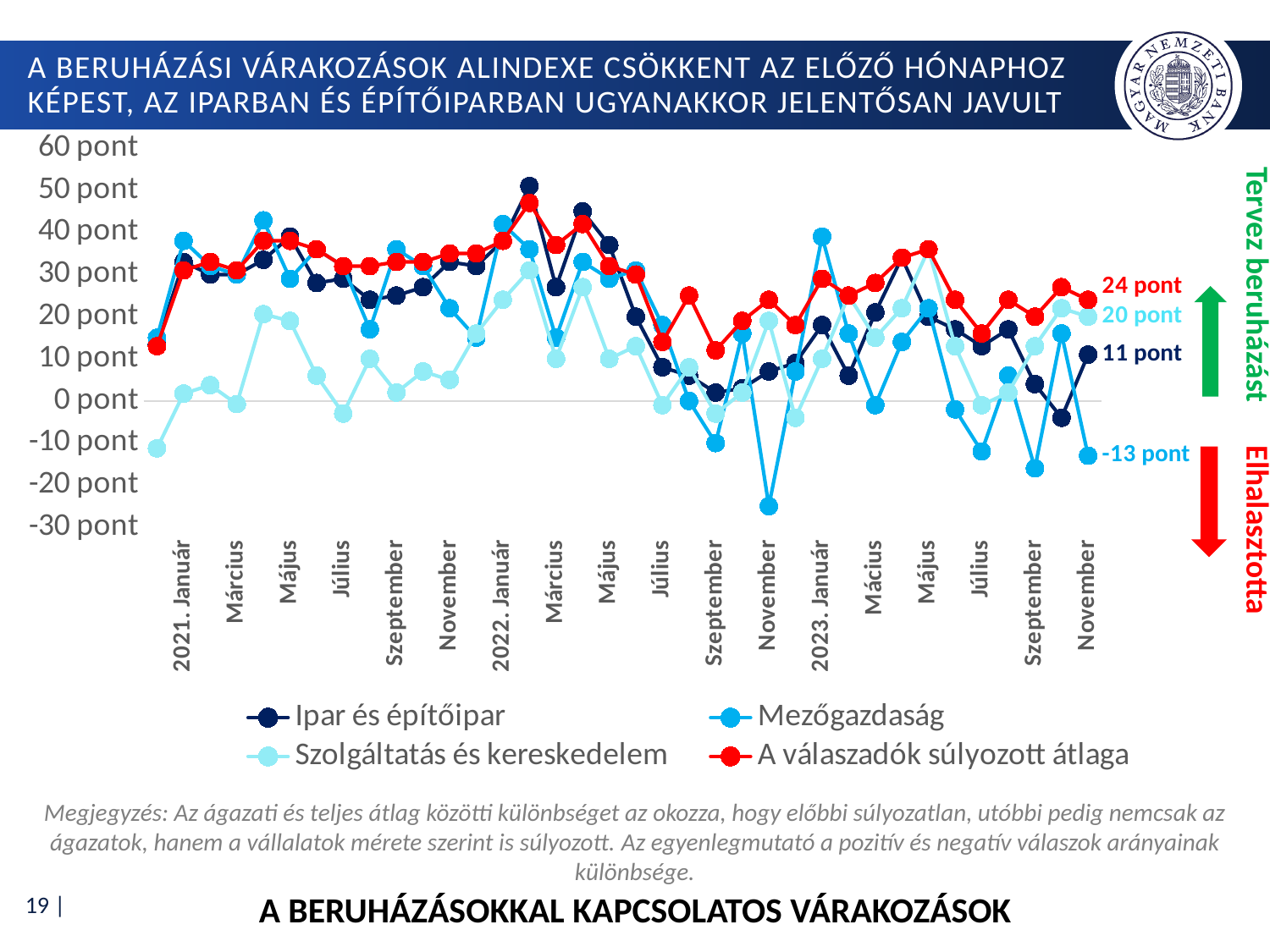
Which series has the highest value at the last point (November 2023)? A válaszadók súlyozott átlaga What is the value of 'Szolgáltatás és kereskedelem' at the last point (November 2023)? 20 pont Between 2022 February and 2022 July, does the 'A válaszadók súlyozott átlaga' line rise or fall? fall Which series has the lowest value at the last point (November 2023)? Mezőgazdaság Is the value for 'Mezőgazdaság' in November 2022 greater or less than -20 pont? less What is the value of 'A válaszadók súlyozott átlaga' at the last point (November 2023)? 24 pont What is the value of 'Ipar és építőipar' at the last point (November 2023)? 11 pont How many series does the legend list? 4 What is the title of the chart shown at the bottom of the slide? A beruházásokkal kapcsolatos várakozások What is the value of 'Mezőgazdaság' at the last point (November 2023)? -13 pont What kind of chart is shown on the slide? line chart What is the difference between the November 2023 values of 'A válaszadók súlyozott átlaga' and 'Ipar és építőipar'? 13 pont